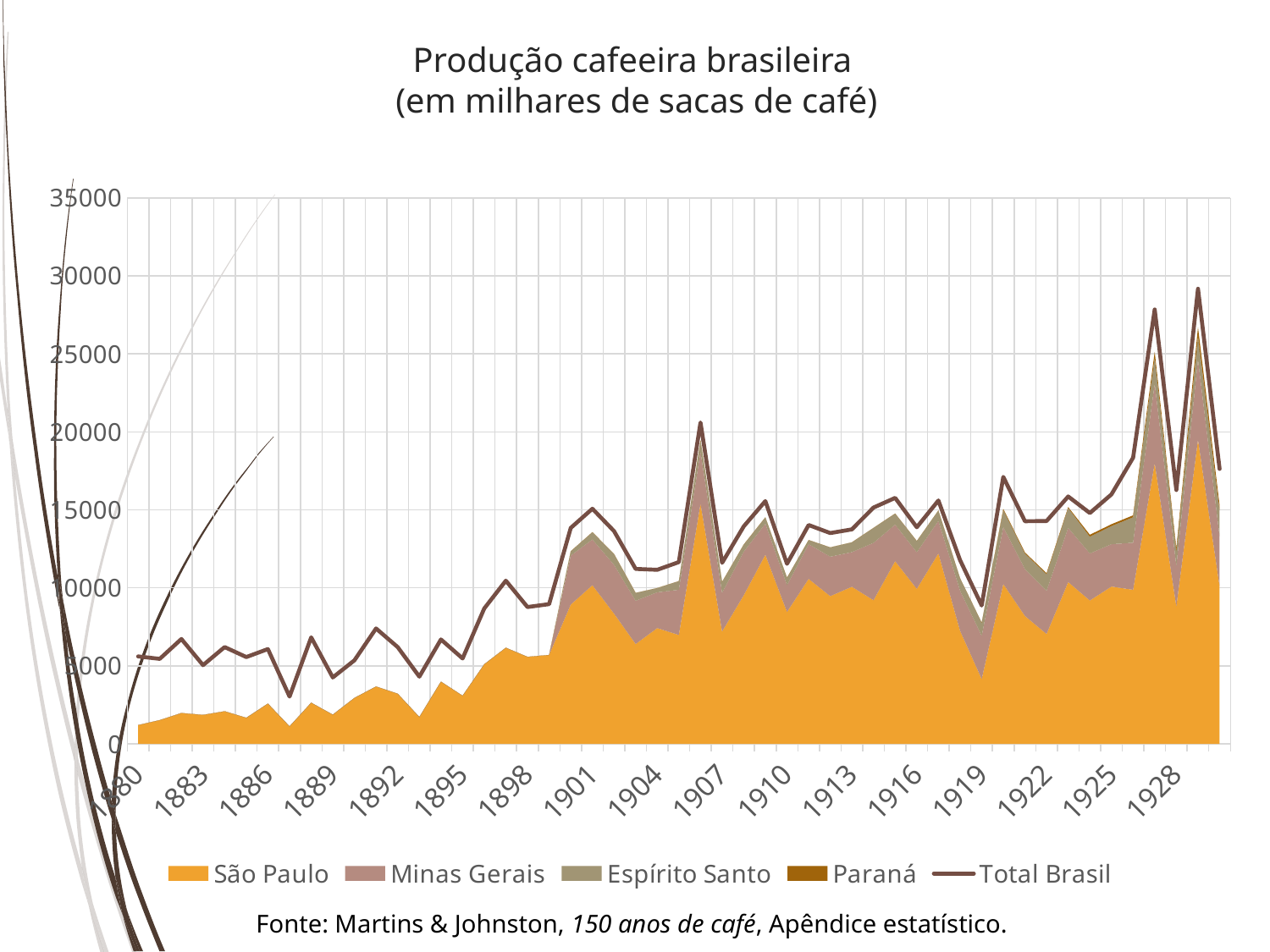
What is the title of the chart? Produção cafeeira brasileira (em milhares de sacas de café) In which year does Total Brasil reach its highest value? 1929 Is the value of Total Brasil in 1880 greater or less than 10000? less Which state contributes the largest share of production throughout the period, São Paulo or Minas Gerais? São Paulo What kind of chart is shown on the slide? Area chart with a line How many series does the legend list? 5 Is the value for São Paulo in 1880 greater or less than 5000? less Which series is drawn as a line rather than a filled area? Total Brasil Is the value of Total Brasil in 1901 greater or less than 10000? greater Does Total Brasil generally rise or fall from 1880 to 1930? rise